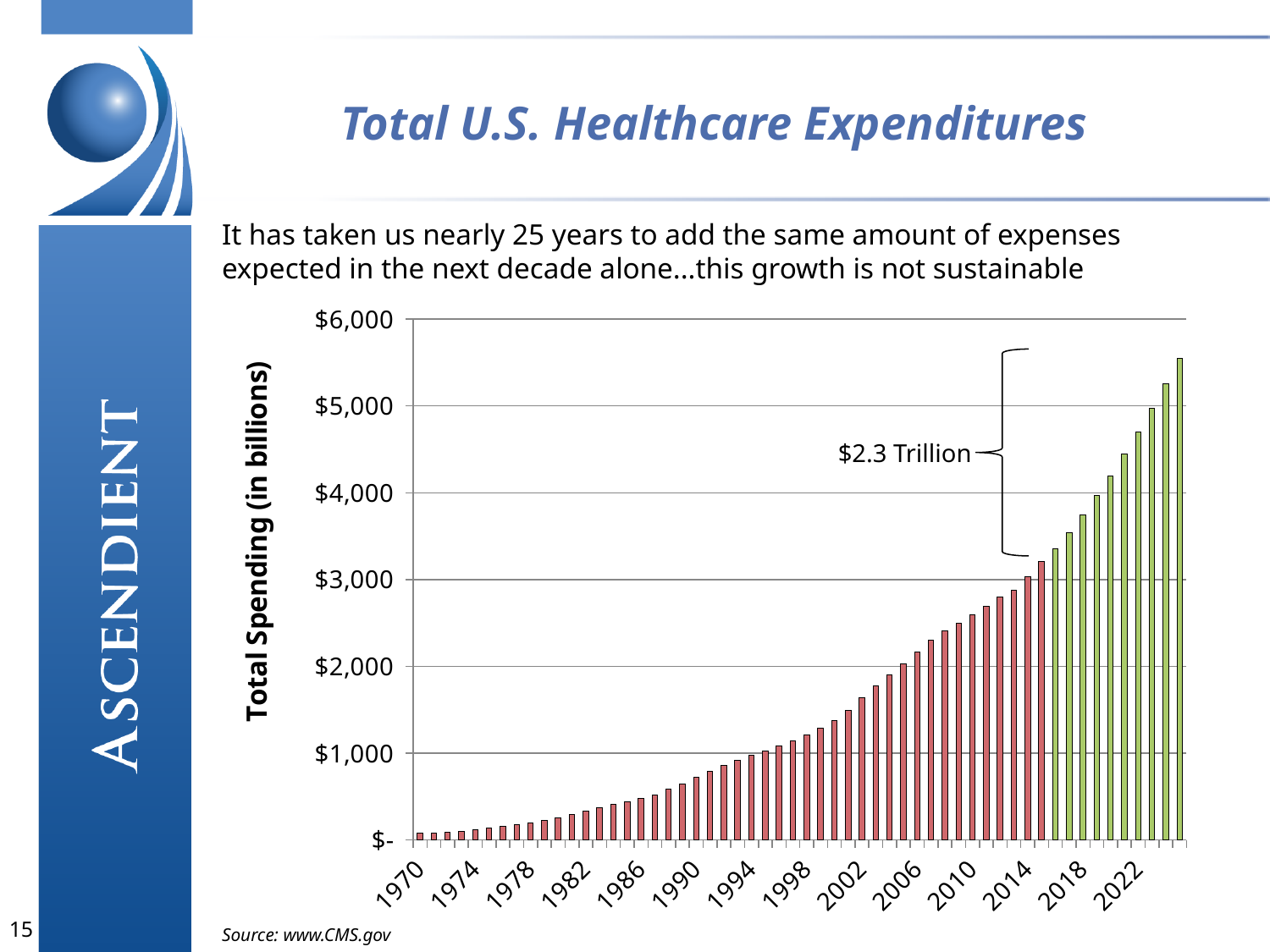
What amount does the bracket annotation on the right side of the chart label? $2.3 Trillion Is the value for 1970 greater or less than $1,000? less Is the value for 2018 greater or less than $3,000? greater Which year has the larger value, 1998 or 2014? 2014 Is the value for 2010 greater or less than $3,000? less Which year has the lowest total spending on the chart? 1970 What is the title of the vertical axis? Total Spending (in billions) What kind of chart is shown on the slide? bar chart Do the values rise or fall as the years move from 1970 toward 2022? rise